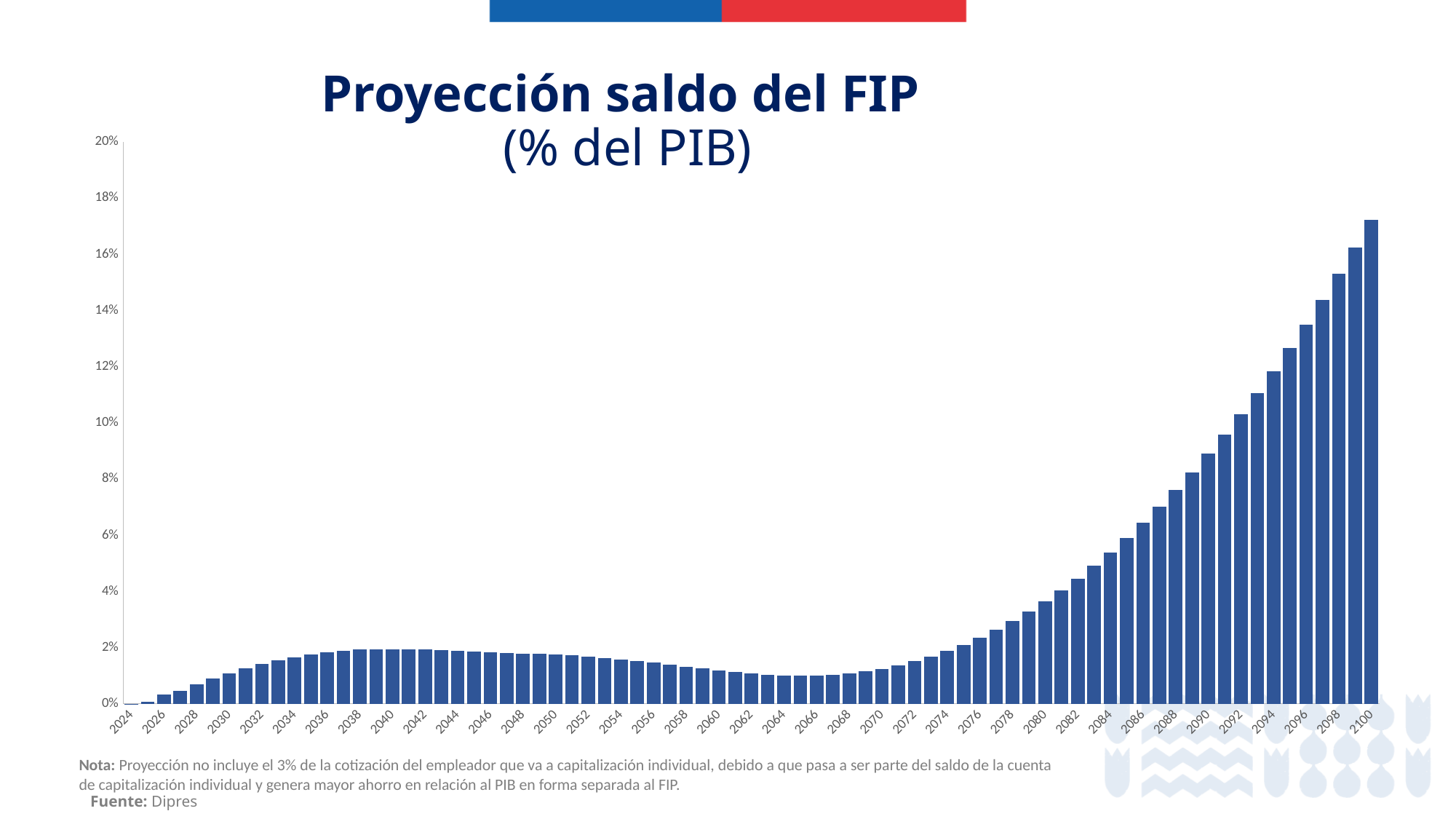
What is the title of the chart? Proyección saldo del FIP (% del PIB) Which year has the highest value in the chart? 2100 Is the value for 2064 greater or less than 2%? less Is the value for 2080 greater or less than 4%? less What is the source cited below the chart? Dipres Do the values generally rise or fall between 2070 and 2100? rise What kind of chart is shown on the slide? bar chart Which year has the lowest value in the chart? 2024 Is the value for 2096 greater or less than 12%? greater Which is larger, the value for 2040 or the value for 2064? 2040